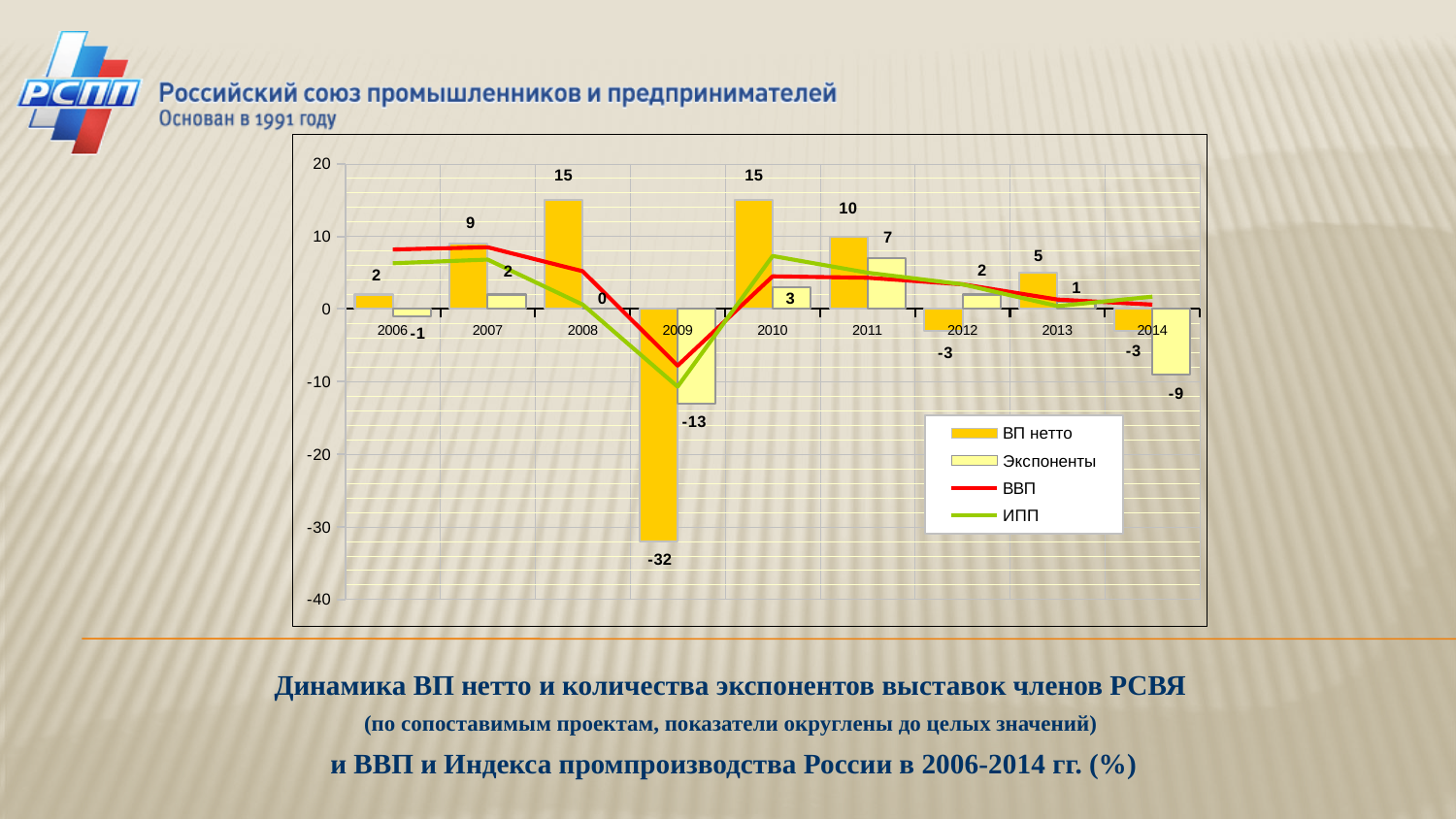
What is the value of ВП нетто in 2009? -32 What is the value of Экспоненты in 2011? 7 In which year is ВП нетто lowest? 2009 What is the difference between ВП нетто and Экспоненты in 2011? 3 How many years are shown on the x axis? 9 What is the value of Экспоненты in 2014? -9 In 2007, which is larger: ВП нетто or Экспоненты? ВП нетто Do the Экспоненты values rise or fall from 2011 to 2014? fall What kind of chart is this? Combined bar and line chart Is the value of ВВП in 2009 greater or less than 0? less In which year is Экспоненты lowest? 2009 How many series does the legend list? 4